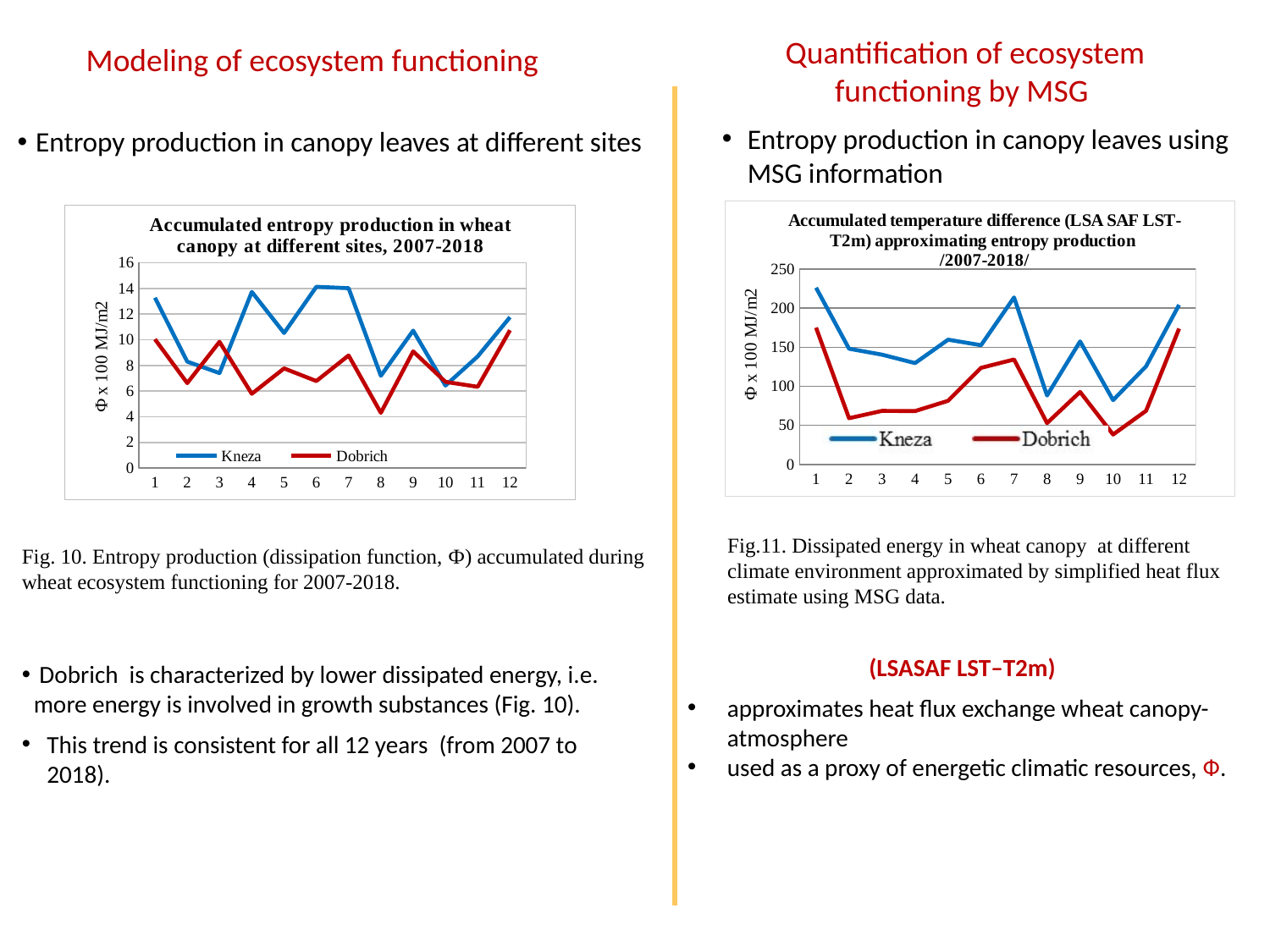
In the left chart, at which x-axis point is the Dobrich series lowest? 8 In the left chart, is the Dobrich value at point 8 greater or less than 6? less In the right chart, is the Kneza value at point 1 greater or less than 200? greater In the right chart, at which x-axis point is the Dobrich series lowest? 10 In the left chart, which series has the larger value at point 4, Kneza or Dobrich? Kneza In the left chart, is the Kneza value at point 1 greater or less than 12? greater How many series does the legend of the left chart list? 2 In the right chart, which series has the larger value at point 7, Kneza or Dobrich? Kneza What kind of chart is the left chart titled 'Accumulated entropy production in wheat canopy at different sites, 2007-2018'? Line chart What are the two series named in the legend of the right chart? Kneza and Dobrich How many points along the x axis does the left chart show for each series? 12